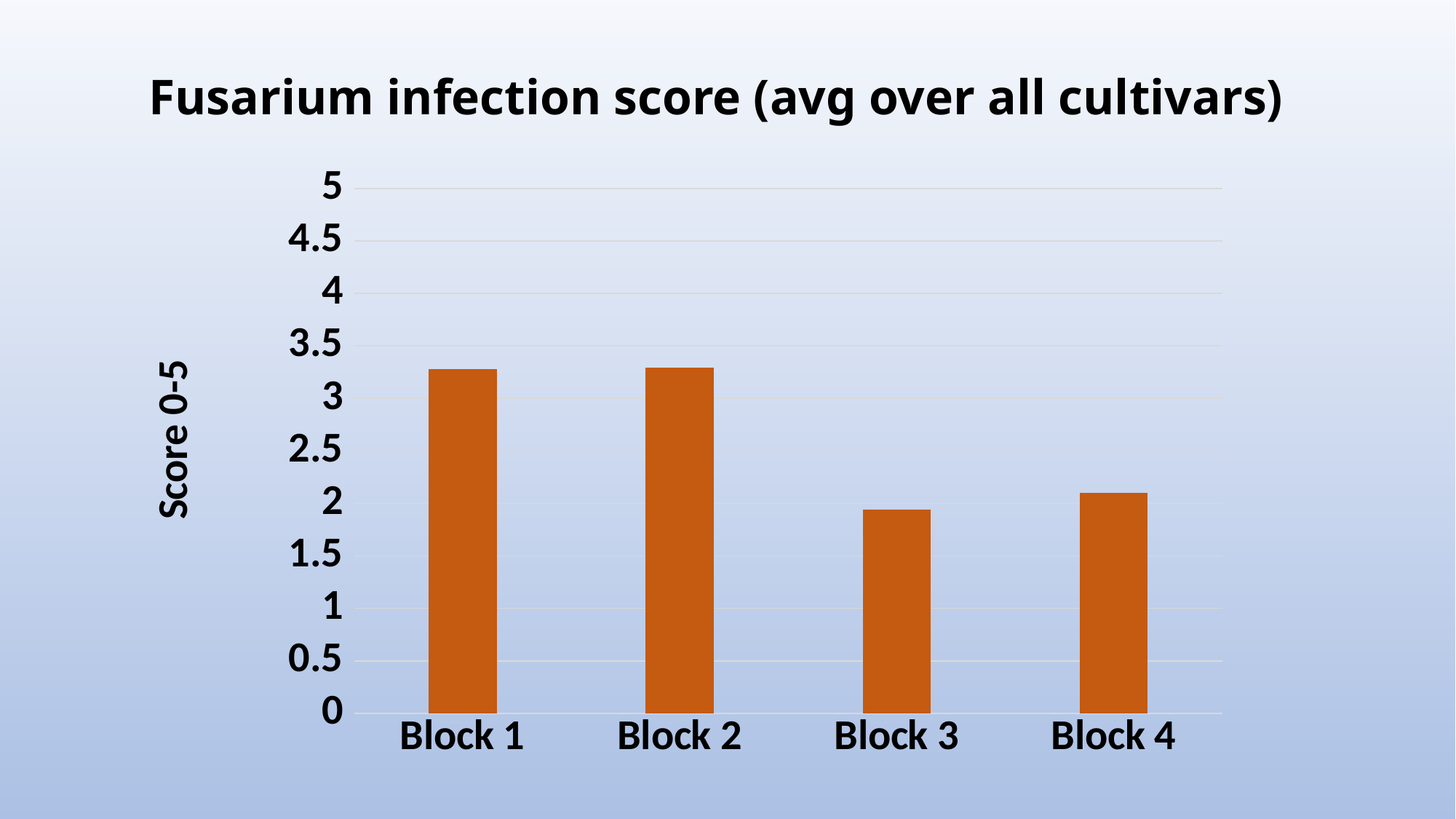
Is the value for Block 4 greater or less than 2? greater Which block has the lowest Fusarium infection score? Block 3 Which has a higher Fusarium infection score, Block 1 or Block 3? Block 1 Which has a higher Fusarium infection score, Block 2 or Block 4? Block 2 What is the title of the chart? Fusarium infection score (avg over all cultivars) What is the label on the vertical axis of the chart? Score 0-5 Is the value for Block 4 greater or less than 2.5? less Is the value for Block 1 greater or less than 3? greater What kind of chart is shown on the slide? bar chart How many blocks are plotted on the chart? 4